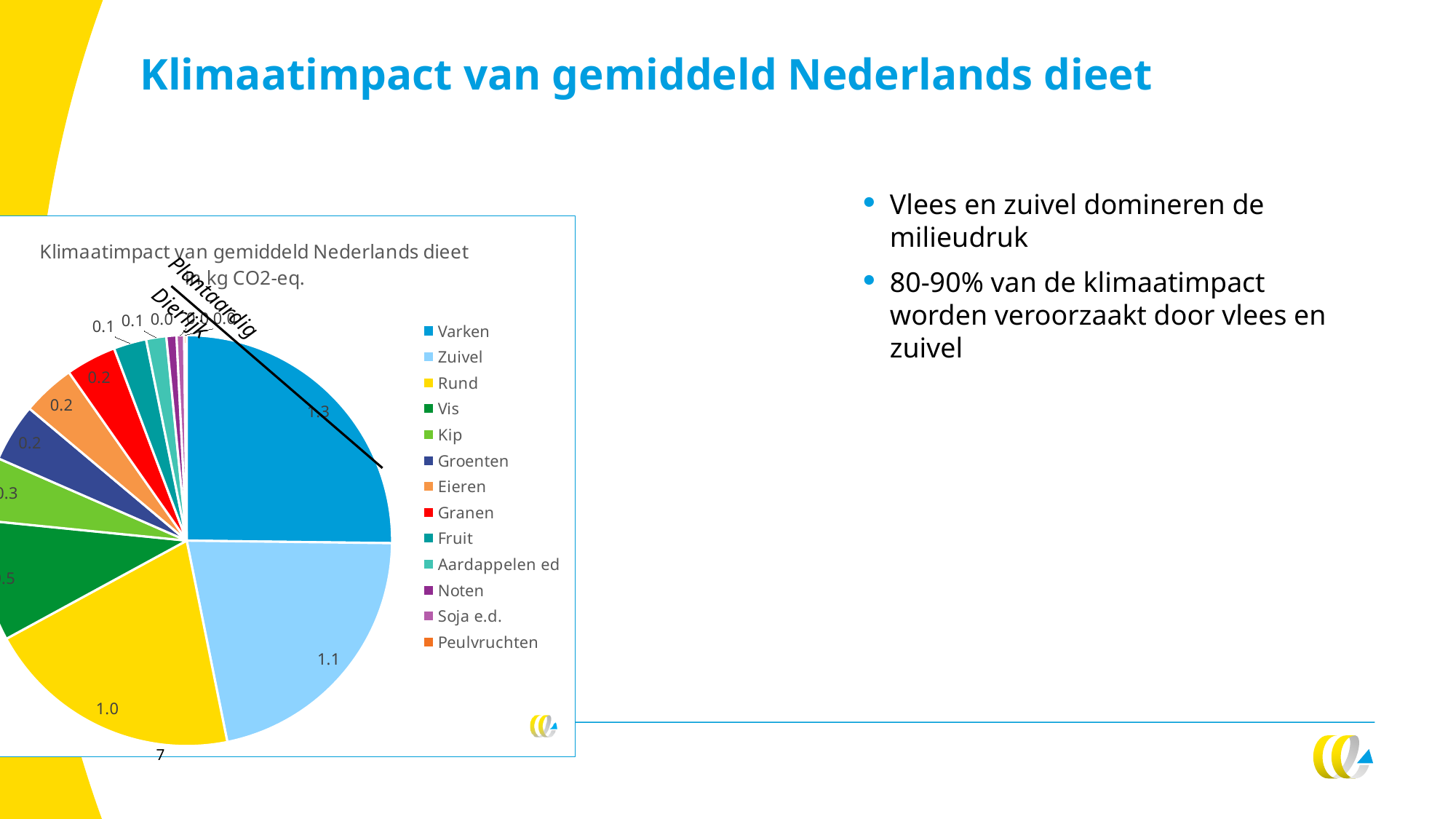
What colour is the Rund slice in the pie chart? yellow Which is larger, the value for Granen or the value for Fruit? Granen What is the value for Rund in the pie chart? 1.0 What kind of chart is shown on the slide? pie chart What is the value for Zuivel in the pie chart? 1.1 What is the title of the pie chart? Klimaatimpact van gemiddeld Nederlands dieet in kg CO2-eq. How many categories does the legend of the pie chart list? 13 Which is larger, the value for Zuivel or the value for Rund? Zuivel What is the value for Eieren in the pie chart? 0.2 Which category has the largest slice in the pie chart? Varken What is the difference between the values for Zuivel and Rund? 0.1 What is the value for Fruit in the pie chart? 0.1